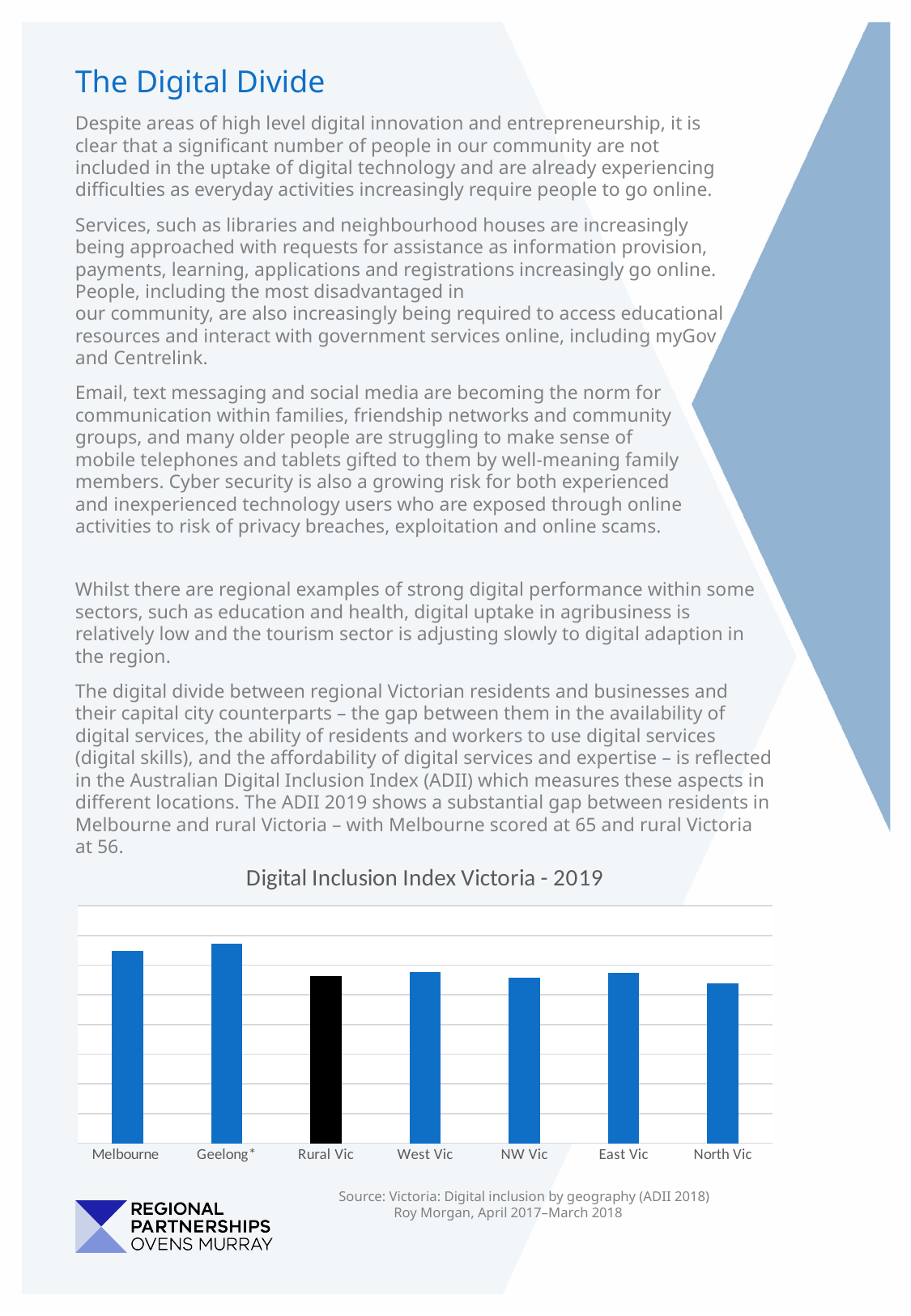
Which is higher in the chart, Melbourne or NW Vic? Melbourne Which is higher in the chart, Geelong* or North Vic? Geelong* Which region's bar is coloured black in the chart? Rural Vic Which is higher in the chart, Geelong* or East Vic? Geelong* Which region has the highest bar in the chart? Geelong* What is the title of the chart? Digital Inclusion Index Victoria - 2019 What kind of chart is shown on the slide? bar chart How many regions are plotted in the chart? 7